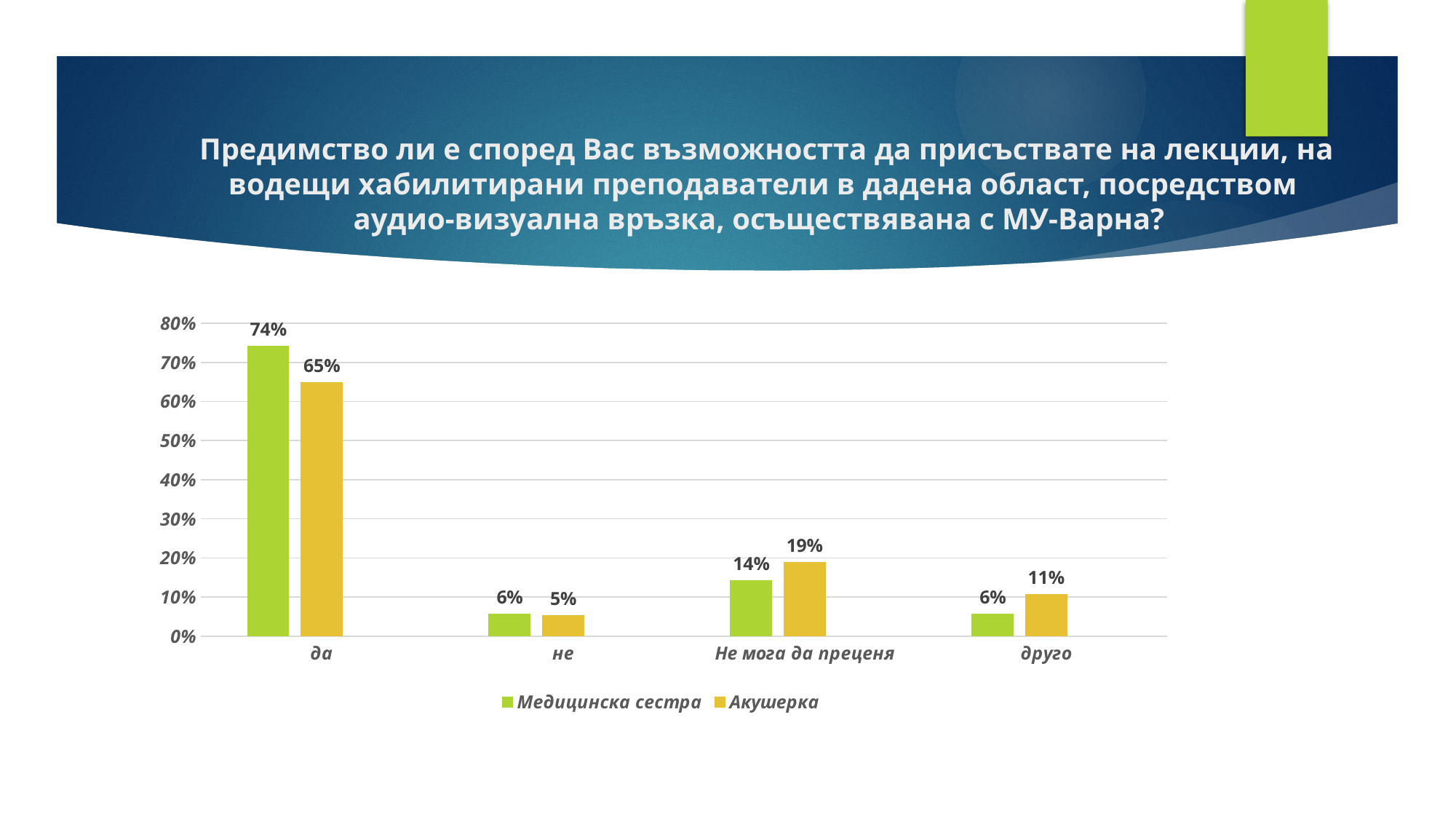
Which category has the highest value for "Акушерка"? да What is the difference between "Медицинска сестра" and "Акушерка" in the "да" category? 9% How many series does the legend list? 2 What kind of chart is shown on the slide? bar chart In the "Не мога да преценя" category, which series has the larger value, "Медицинска сестра" or "Акушерка"? Акушерка Which colour represents the "Акушерка" series? yellow What is the value for "Акушерка" in the "друго" category? 11% How many categories are shown on the x axis? 4 Is the value for "Медицинска сестра" in the "да" category greater or less than 70%? greater What is the value for "Медицинска сестра" in the "да" category? 74% What is the value for "Акушерка" in the "Не мога да преценя" category? 19% Which category has the lowest value for "Акушерка"? не